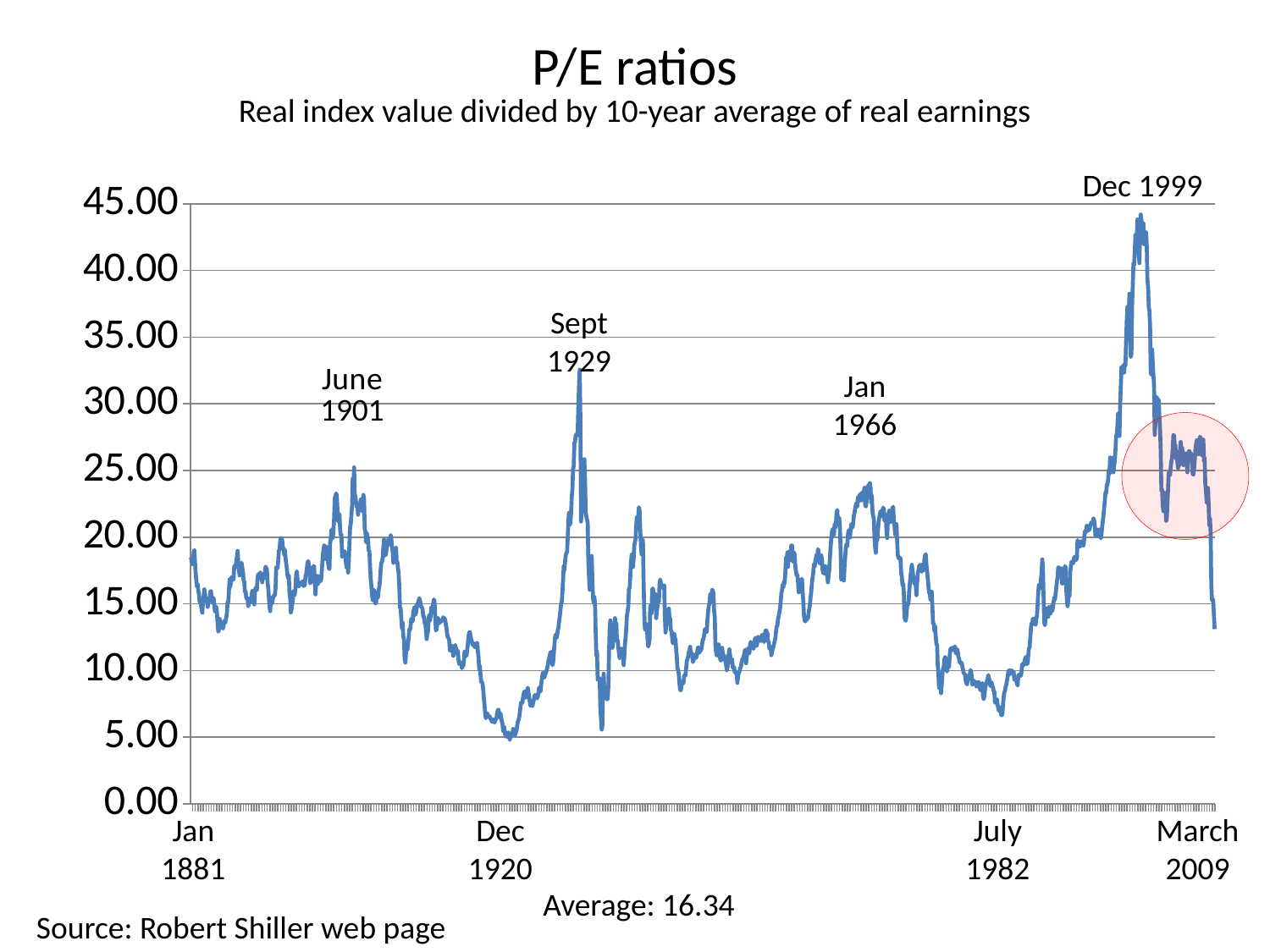
What average value is printed below the chart? 16.34 How many dated peaks are labelled on the chart? 4 Which of the four labelled peaks (June 1901, Sept 1929, Jan 1966, Dec 1999) has the highest P/E ratio? Dec 1999 Is the P/E ratio around Dec 1920 greater or less than 10.00? less Does the P/E ratio rise or fall between the Dec 1999 peak and March 2009? fall What is the title of the chart? P/E ratios What kind of chart is shown on the slide? line chart What is the first date shown on the x axis? Jan 1881 Which peak has the larger P/E ratio, Sept 1929 or Jan 1966? Sept 1929 Is the P/E ratio at the Jan 1966 peak greater or less than 25.00? less Is the P/E ratio at the Dec 1999 peak greater or less than 40.00? greater